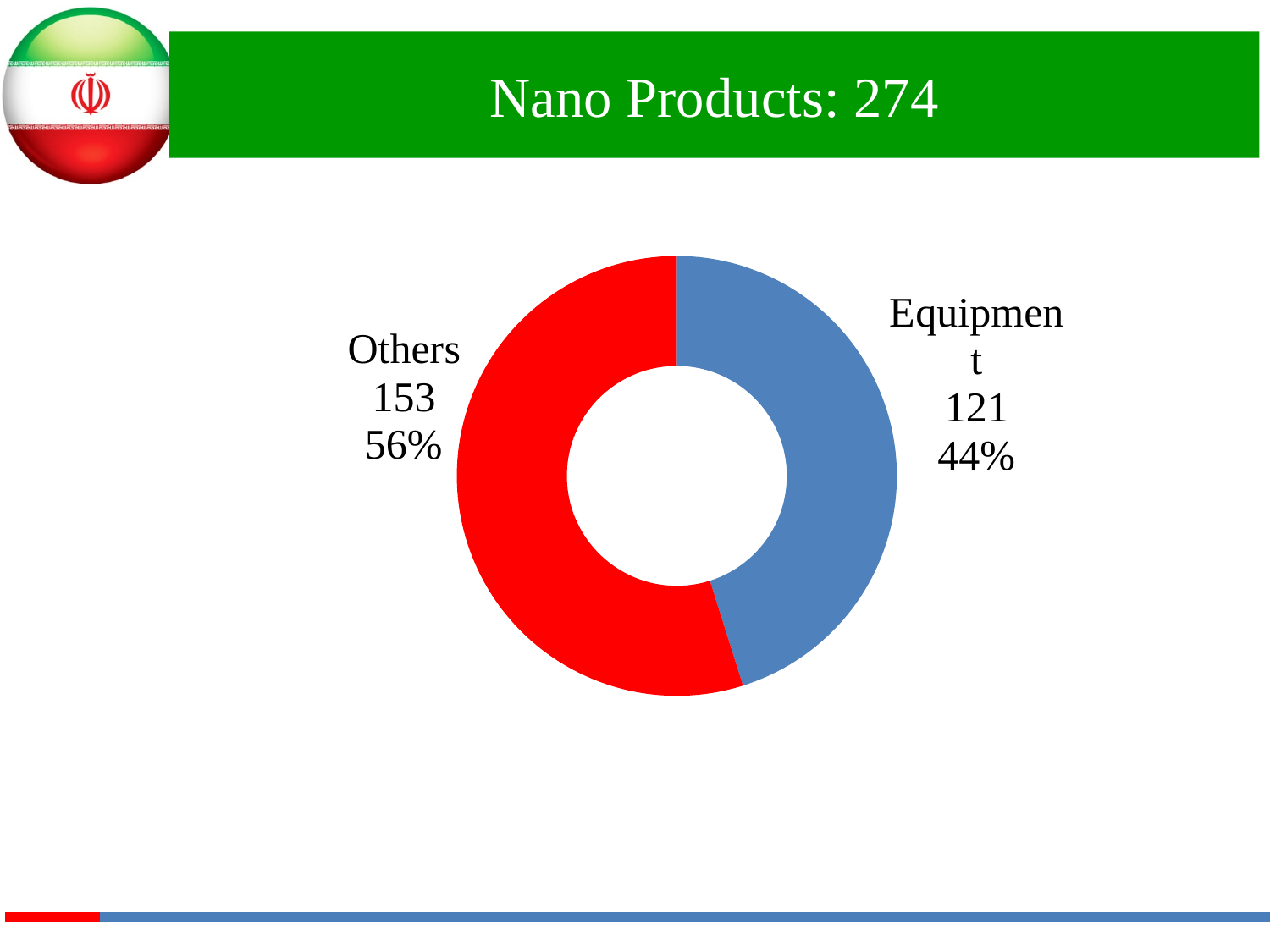
What percentage share does Equipment have? 44% What is the total of the two slices? 274 What kind of chart is shown on the slide? Doughnut chart What colour is the Equipment slice? Blue How many categories are shown in the chart? 2 Which category has the smallest slice? Equipment Which category has the largest slice? Others What is the difference between the values for Others and Equipment? 32 What is the value for Others? 153 Which is larger, Others or Equipment? Others What is the value for Equipment? 121 What percentage share does Others have? 56%